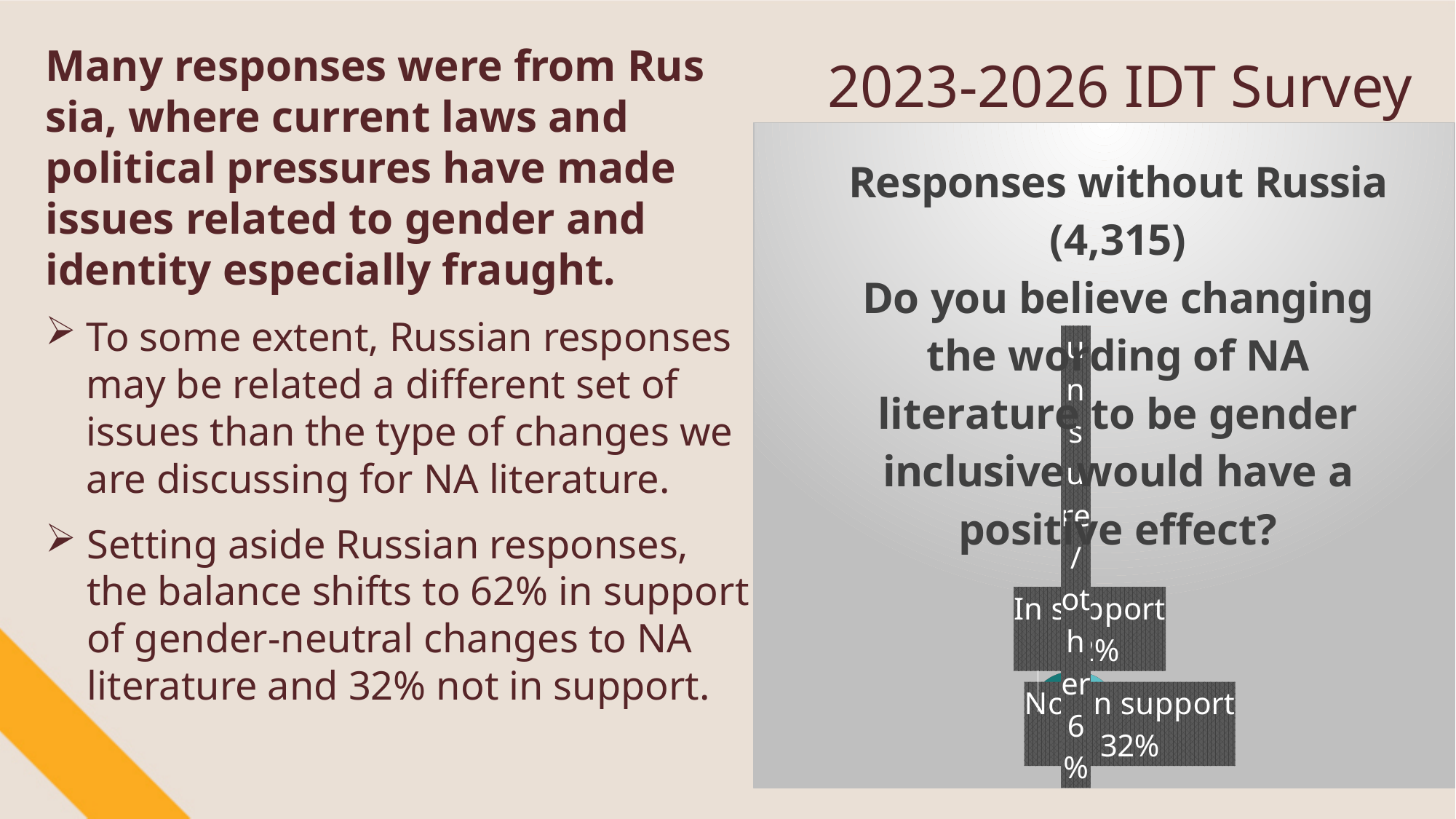
What percentage of responses were 'Not in support' in the Responses without Russia chart? 32% What percentage of responses were 'Unsure/other' in the Responses without Russia chart? 6% Which category has the smallest share in the Responses without Russia chart? Unsure/other By how many percentage points does 'Not in support' exceed 'Unsure/other' in the Responses without Russia chart? 26 percentage points What survey question does the chart title say the responses are for? Do you believe changing the wording of NA literature to be gender inclusive would have a positive effect? How many responses does the chart title say were counted without Russia? 4,315 How many response categories does the Responses without Russia chart show? 3 Which is larger in the Responses without Russia chart: 'Not in support' or 'Unsure/other'? Not in support Which category has the largest share in the Responses without Russia chart? In support